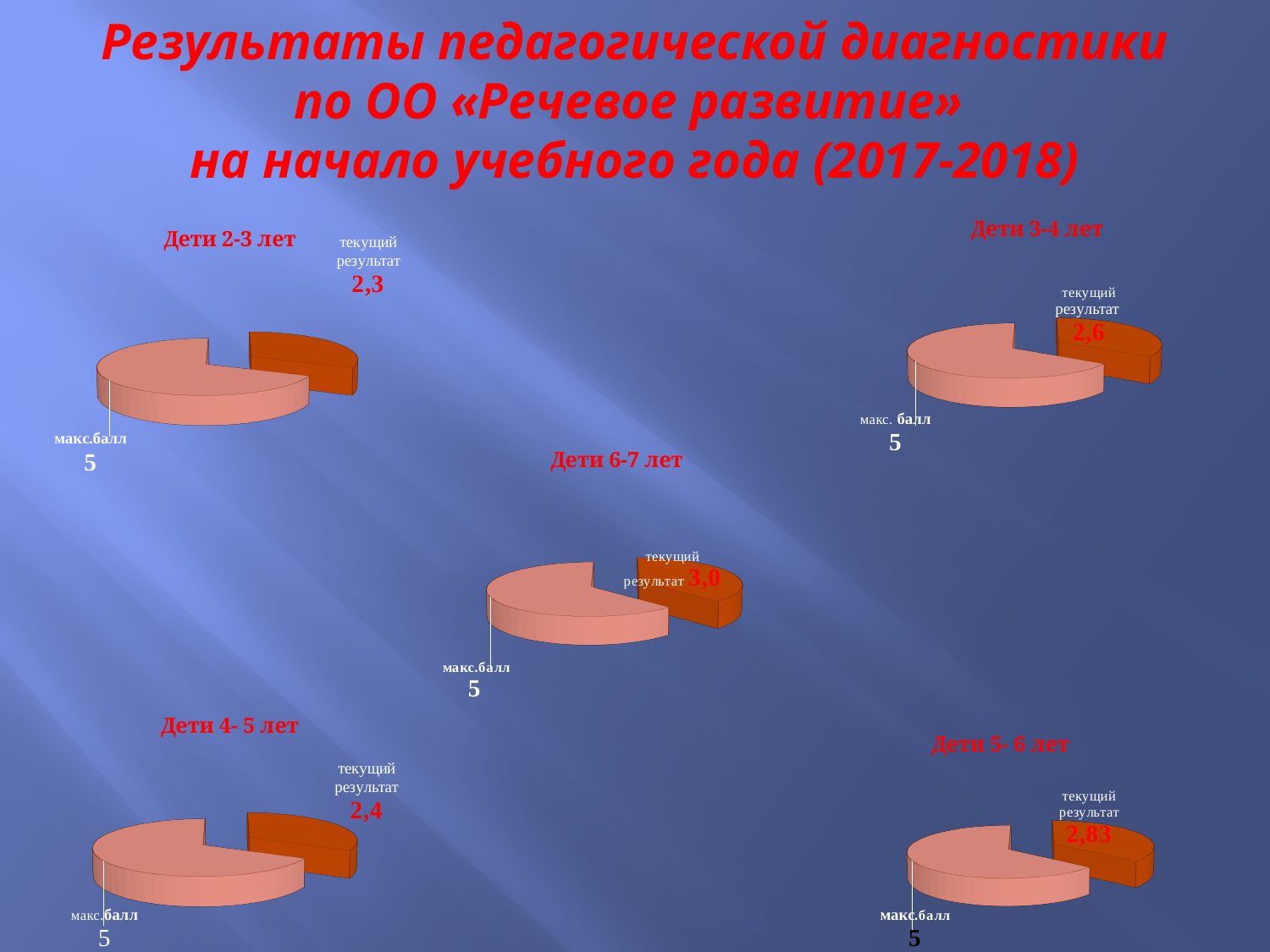
In the chart titled "Дети 4- 5 лет", what is the value of "текущий результат"? 2,4 In the chart titled "Дети 2-3 лет", what is the value of "текущий результат"? 2,3 How many pie charts are shown on the slide? 5 Across all the charts on the slide, which age group has the lowest "текущий результат"? Дети 2-3 лет In the chart titled "Дети 2-3 лет", what is the value of "макс.балл"? 5 How many slices does the chart titled "Дети 4- 5 лет" have? 2 In the chart titled "Дети 2-3 лет", what is the difference between "макс.балл" and "текущий результат"? 2,7 Across all the charts on the slide, which age group has the highest "текущий результат"? Дети 6-7 лет What kind of chart is the one titled "Дети 6-7 лет"? Pie chart In the chart titled "Дети 5- 6 лет", what is the value of "текущий результат"? 2,83 In the chart titled "Дети 3-4 лет", what is the value of "текущий результат"? 2,6 In the chart titled "Дети 6-7 лет", what is the value of "текущий результат"? 3,0